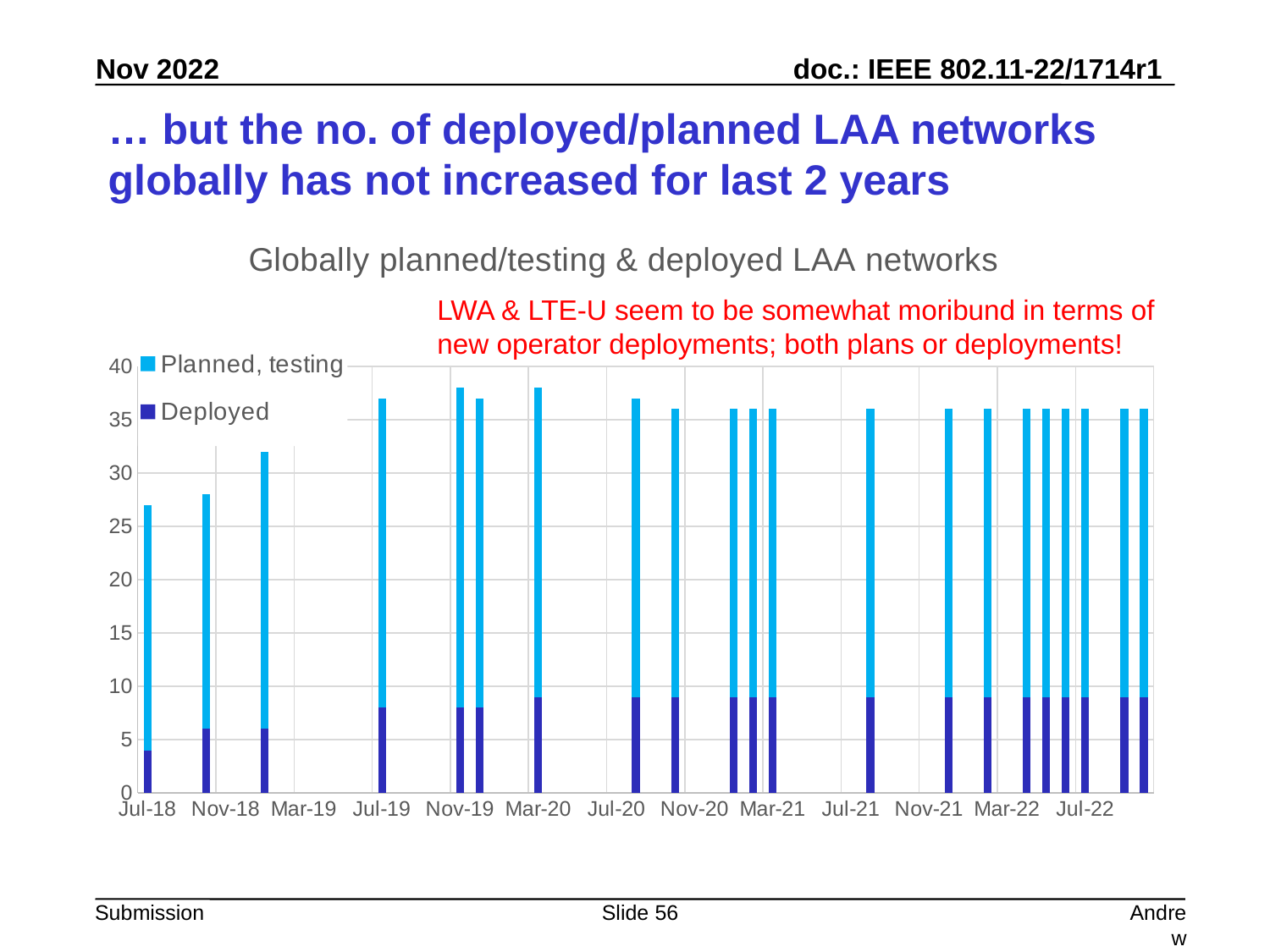
Do the total bar heights rise or fall from Jul-18 to Jul-19? rise What kind of chart is shown on the slide? Stacked bar chart Is the total height of the bar at Jul-18 greater or less than 30? less Which is larger, the Deployed value at Jul-18 or the Deployed value at Jul-22? Jul-22 Is the total height of the bar at Nov-18 greater or less than 25? greater Is the Deployed value at Jul-22 greater or less than 5? greater What is the title of the chart? Globally planned/testing & deployed LAA networks Which is larger, the total bar at Jul-18 or the total bar at Jul-19? Jul-19 How many series does the chart legend list? 2 How many labelled tick marks are shown on the x axis? 13 Which series is shown in dark blue in the chart? Deployed